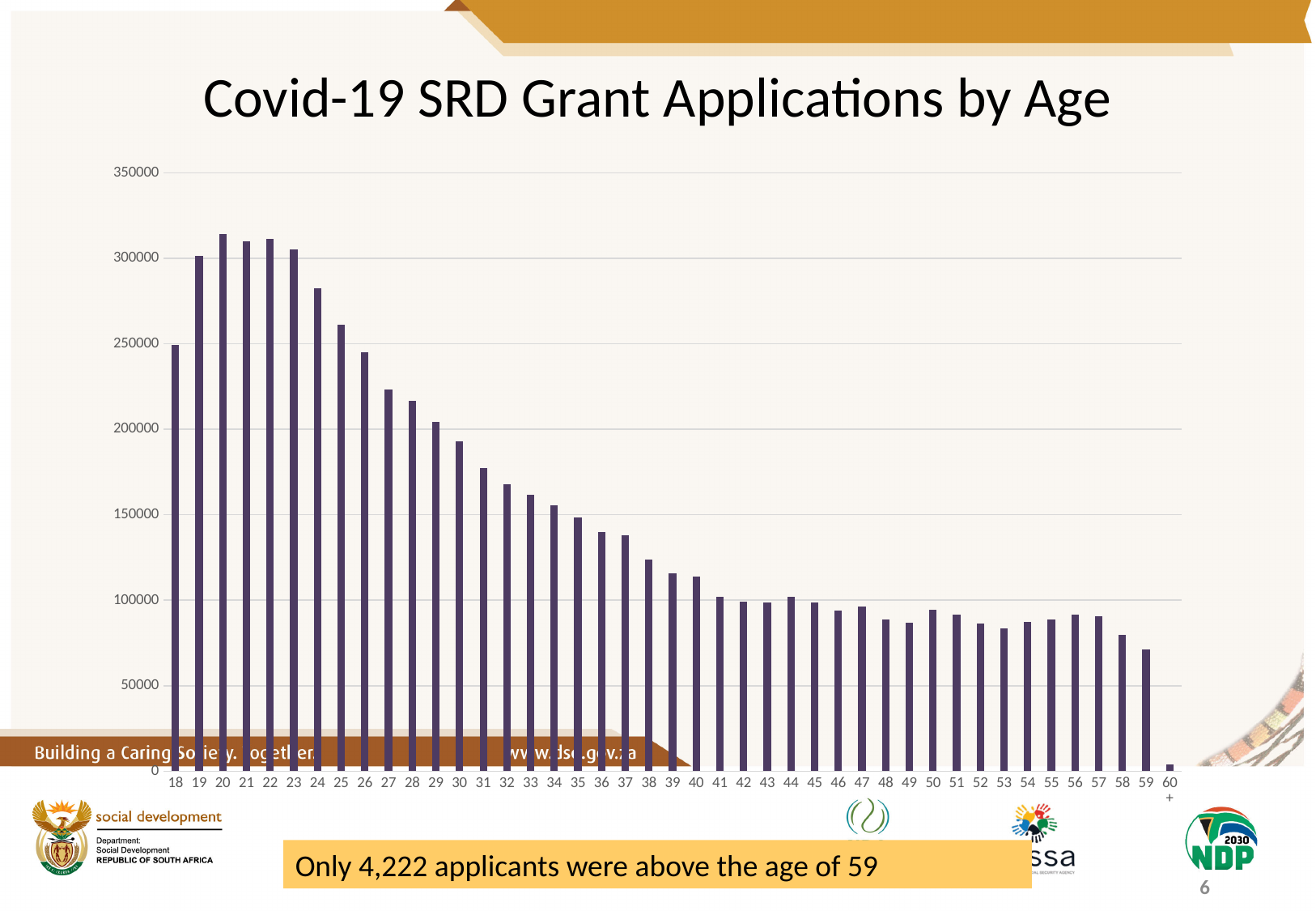
What is the title of the chart? Covid-19 SRD Grant Applications by Age Which has more applications, age 18 or age 19? age 19 According to the text on the slide, how many applicants were above the age of 59? 4,222 Is the value for age 24 greater or less than 250000? greater Is the value for age 59 greater or less than 100000? less Is the value for age 30 greater or less than 200000? less What kind of chart is shown on the slide? bar chart From age 22 onward, do the values generally rise or fall as age increases? fall How many age categories are shown on the x axis? 43 Which age category has the lowest number of applications? 60+ Which has more applications, age 25 or age 30? age 25